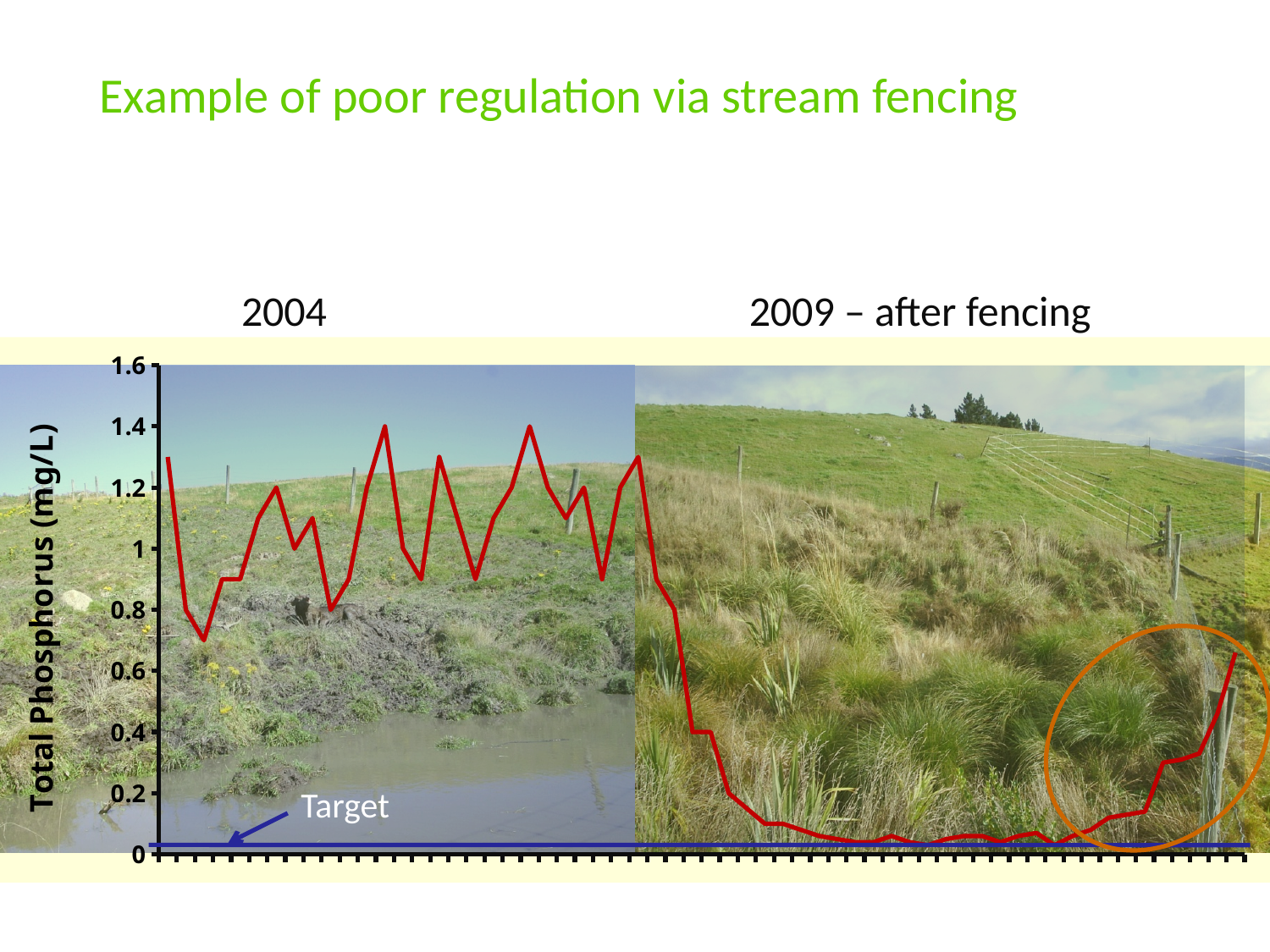
What kind of chart is shown on the slide? line chart What is the label of the vertical axis of the chart? Total Phosphorus (mg/L) Which period shows higher phosphorus values overall, 2004 or 2009 – after fencing? 2004 Do the plotted phosphorus values rise or fall when moving from the 2004 period to the 2009 period? fall Is the lowest point of the red line in the 2004 period greater or less than 0.6? greater What does the blue horizontal line near the bottom of the chart represent? Target What is the highest tick value shown on the vertical axis? 1.6 Is the final value of the red line at the right end of the chart greater or less than 0.4? greater Is the highest peak of the red line in the 2004 period greater or less than 1.2? greater